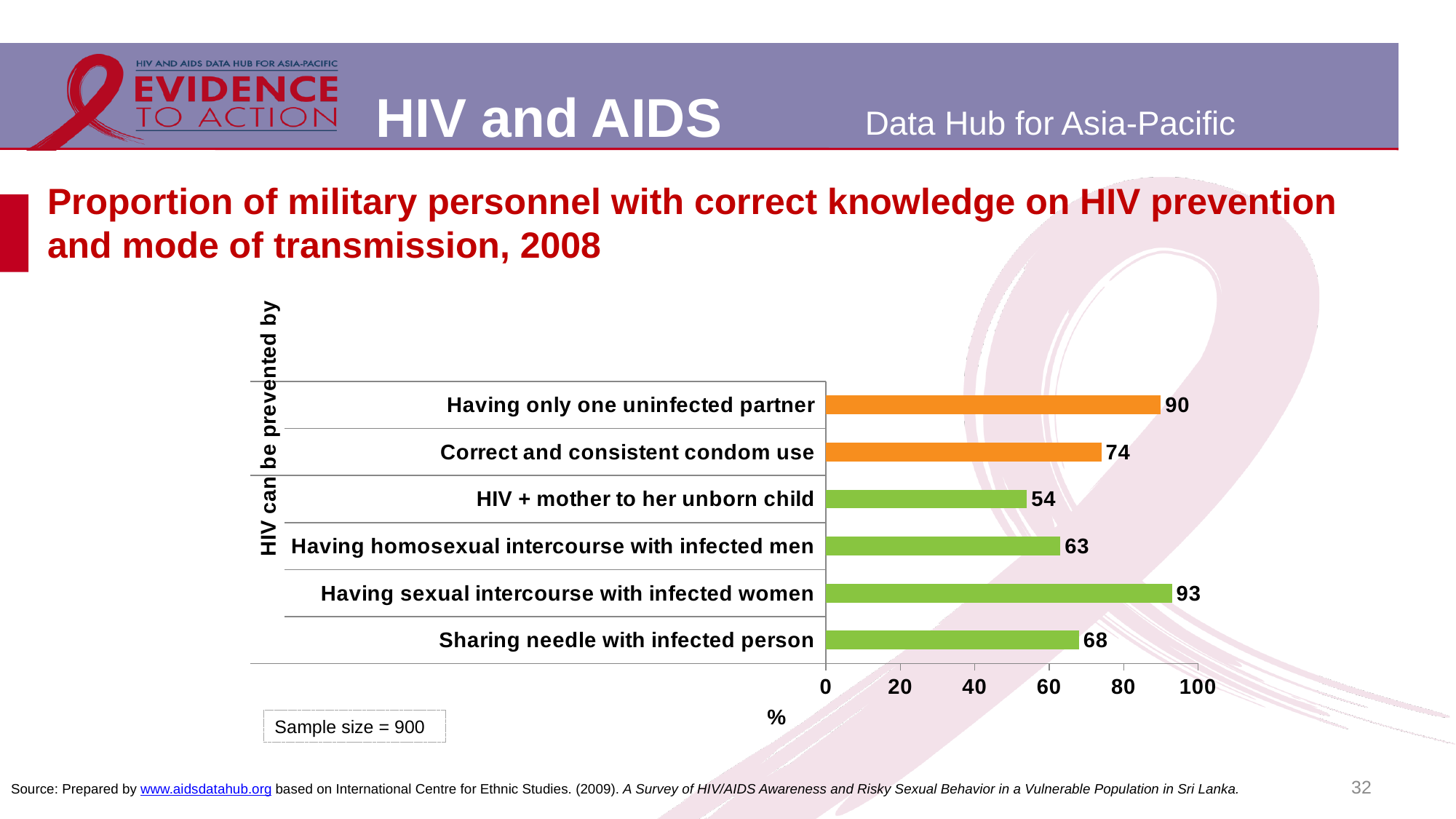
What kind of chart is shown on the slide? Bar chart What is the sample size stated on the slide? 900 What is the difference between the values for 'Having only one uninfected partner' and 'Correct and consistent condom use'? 16 Which category has the lowest value? HIV + mother to her unborn child What is the value for 'Having only one uninfected partner'? 90 What is the value for 'Correct and consistent condom use'? 74 Which category has the highest value? Having sexual intercourse with infected women Is the value for 'Having homosexual intercourse with infected men' greater or less than 60? greater What is the value for 'Sharing needle with infected person'? 68 What is the value for 'HIV + mother to her unborn child'? 54 Which is larger: the value for 'Having homosexual intercourse with infected men' or 'Sharing needle with infected person'? Sharing needle with infected person How many categories are shown in the chart? 6